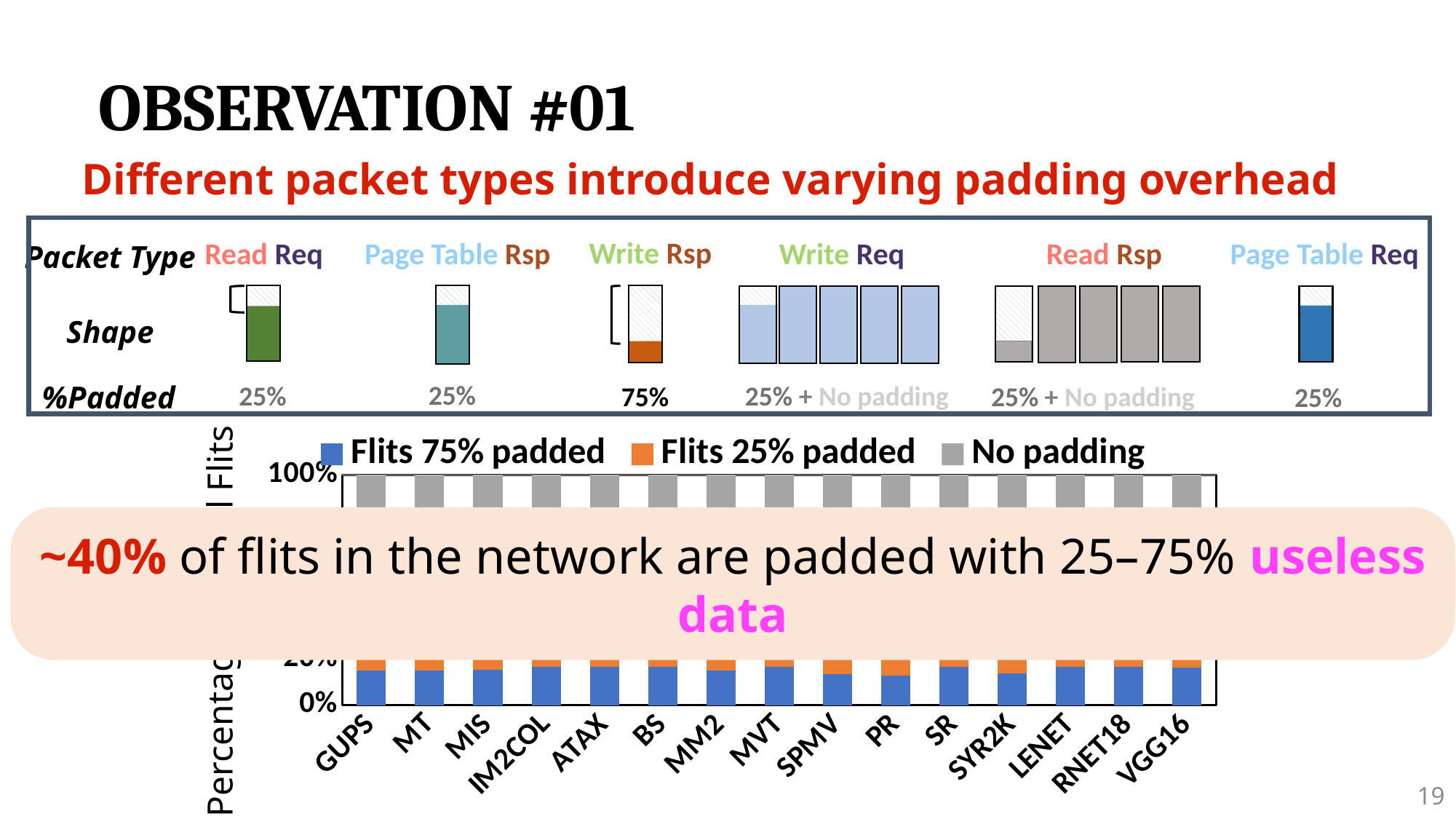
Is the 'Flits 75% padded' value for GUPS greater or less than 20%? less Is the 'Flits 75% padded' value for PR greater or less than 20%? less Is the 'Flits 75% padded' value for VGG16 greater or less than 20%? less Which is larger in the bar chart: the 'Flits 75% padded' value for LENET or for SPMV? LENET What kind of chart is shown at the bottom of the slide? stacked bar chart What is the first category on the x axis of the bar chart? GUPS Which is larger in the bar chart: the 'Flits 75% padded' value for BS or for PR? BS Which colour represents the 'No padding' series in the bar chart? grey How many series does the legend of the bar chart list? 3 What are the three series named in the legend of the bar chart? Flits 75% padded, Flits 25% padded, No padding How many benchmark categories are shown on the x axis of the bar chart? 15